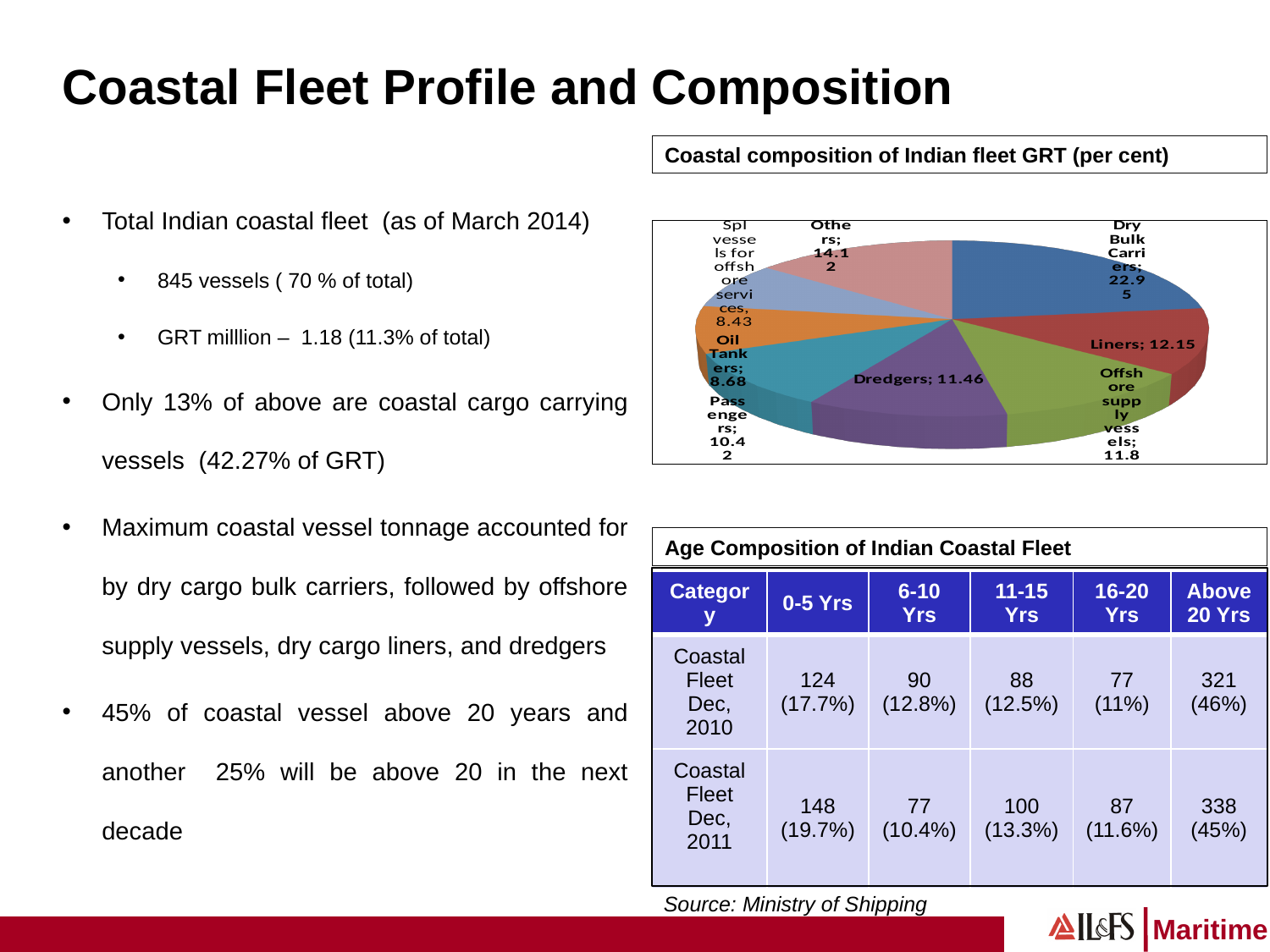
What is the title of the pie chart? Coastal composition of Indian fleet GRT (per cent) What type of chart is shown on the slide? Pie chart Which category has the smallest share in the pie chart? Spl vessels for offshore services What is the value for Dredgers in the pie chart? 11.46 What is the value for Dry Bulk Carriers in the pie chart? 22.95 What is the value for Others in the pie chart? 14.12 Which category has the largest share in the pie chart? Dry Bulk Carriers What is the value for Liners in the pie chart? 12.15 Which is larger in the pie chart, Offshore supply vessels or Passengers? Offshore supply vessels What is the value for Oil Tankers in the pie chart? 8.68 What is the difference between the values for Dry Bulk Carriers and Liners in the pie chart? 10.8 How many categories are shown in the pie chart? 8